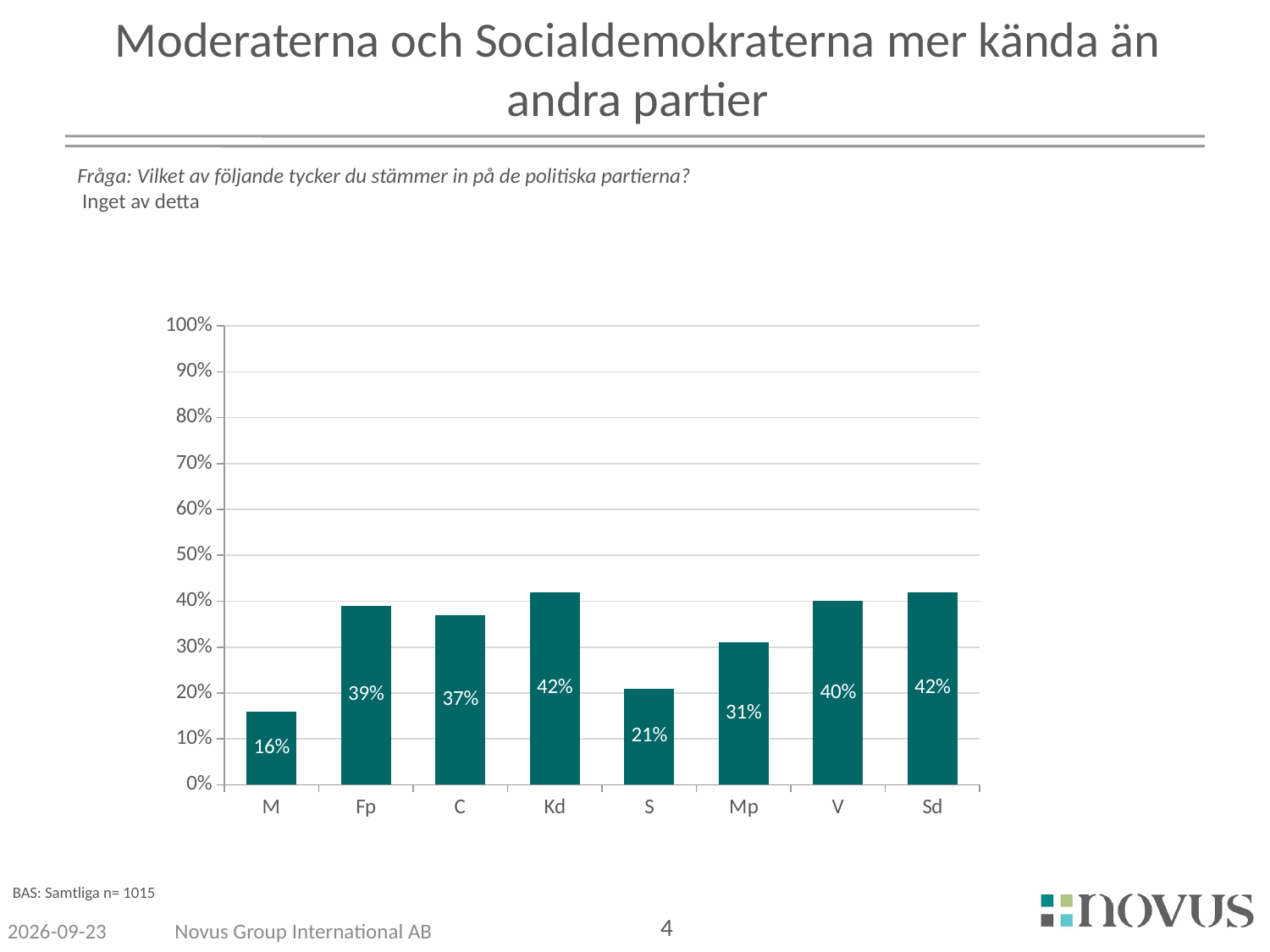
What is the difference between the values for Fp and C? 2% How many categories are shown on the x axis? 8 Is the value for Sd greater or less than 50%? less What is the value for Mp? 31% Which category has the lowest value? M What is the value for M? 16% Which is larger, the value for Mp or the value for S? Mp What is the difference between the values for V and M? 24% What is the highest value shown on the y axis? 100% What is the value for Kd? 42% What kind of chart is shown on the slide? bar chart What is the value for S? 21%